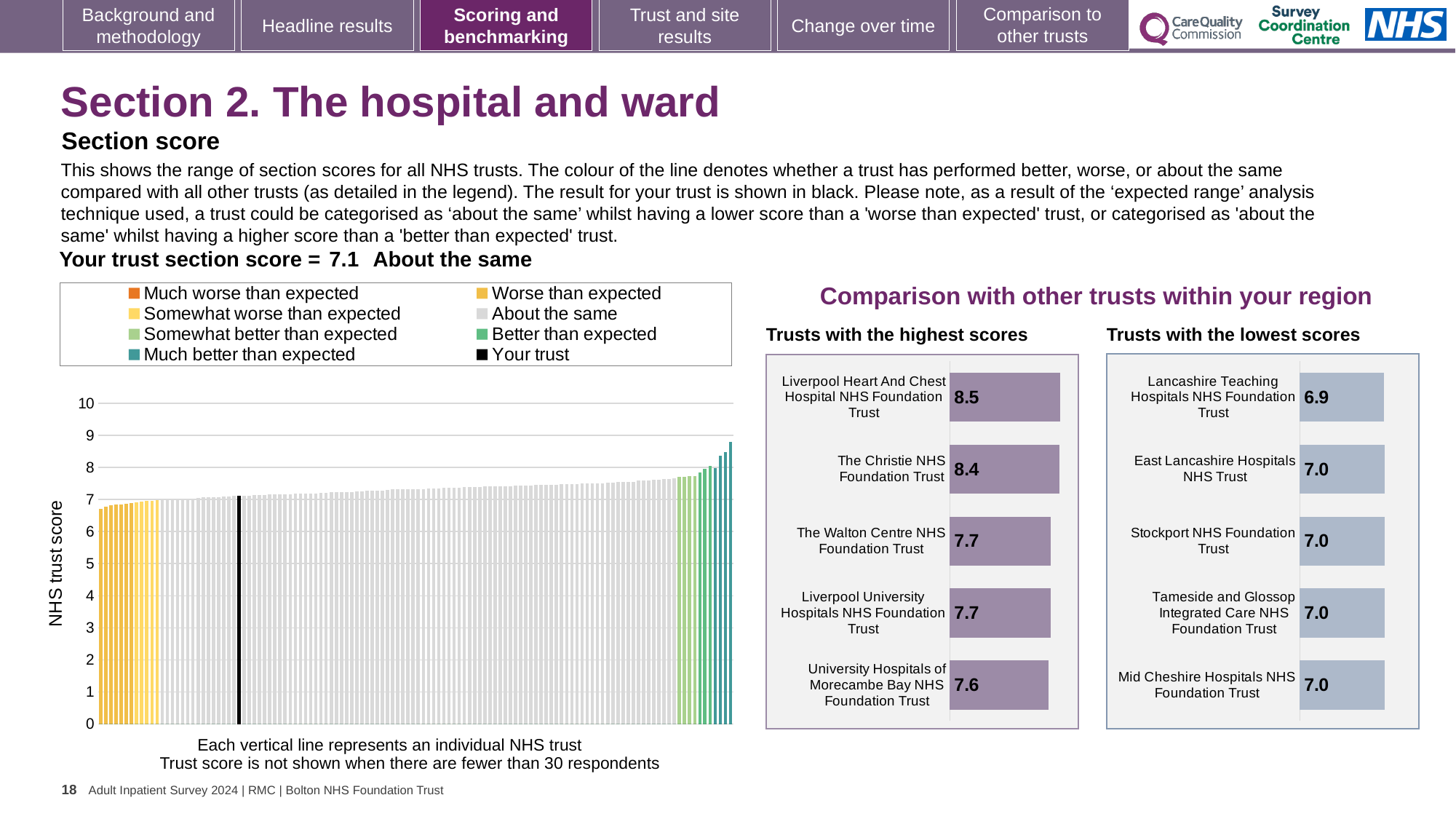
In the 'Trusts with the highest scores' chart, what is the score for Liverpool Heart And Chest Hospital NHS Foundation Trust? 8.5 In the 'Trusts with the lowest scores' chart, which trust has the lowest score? Lancashire Teaching Hospitals NHS Foundation Trust How many entries does the legend above the 'NHS trust score' chart list? 8 In the 'Trusts with the lowest scores' chart, what is the score for Lancashire Teaching Hospitals NHS Foundation Trust? 6.9 In the 'Trusts with the highest scores' chart, which trust has the highest score? Liverpool Heart And Chest Hospital NHS Foundation Trust What kind of chart is the large 'NHS trust score' chart on the left of the slide? bar chart What is the section score for your trust shown on the slide? 7.1 How many trusts are shown in the 'Trusts with the lowest scores' chart? 5 In the 'NHS trust score' chart, do the bar values rise or fall from left to right? rise In the 'Trusts with the highest scores' chart, which trust has the lowest score? University Hospitals of Morecambe Bay NHS Foundation Trust In the 'Trusts with the highest scores' chart, what is the score for The Christie NHS Foundation Trust? 8.4 In the 'Trusts with the highest scores' chart, what is the difference between the scores of Liverpool Heart And Chest Hospital NHS Foundation Trust and University Hospitals of Morecambe Bay NHS Foundation Trust? 0.9